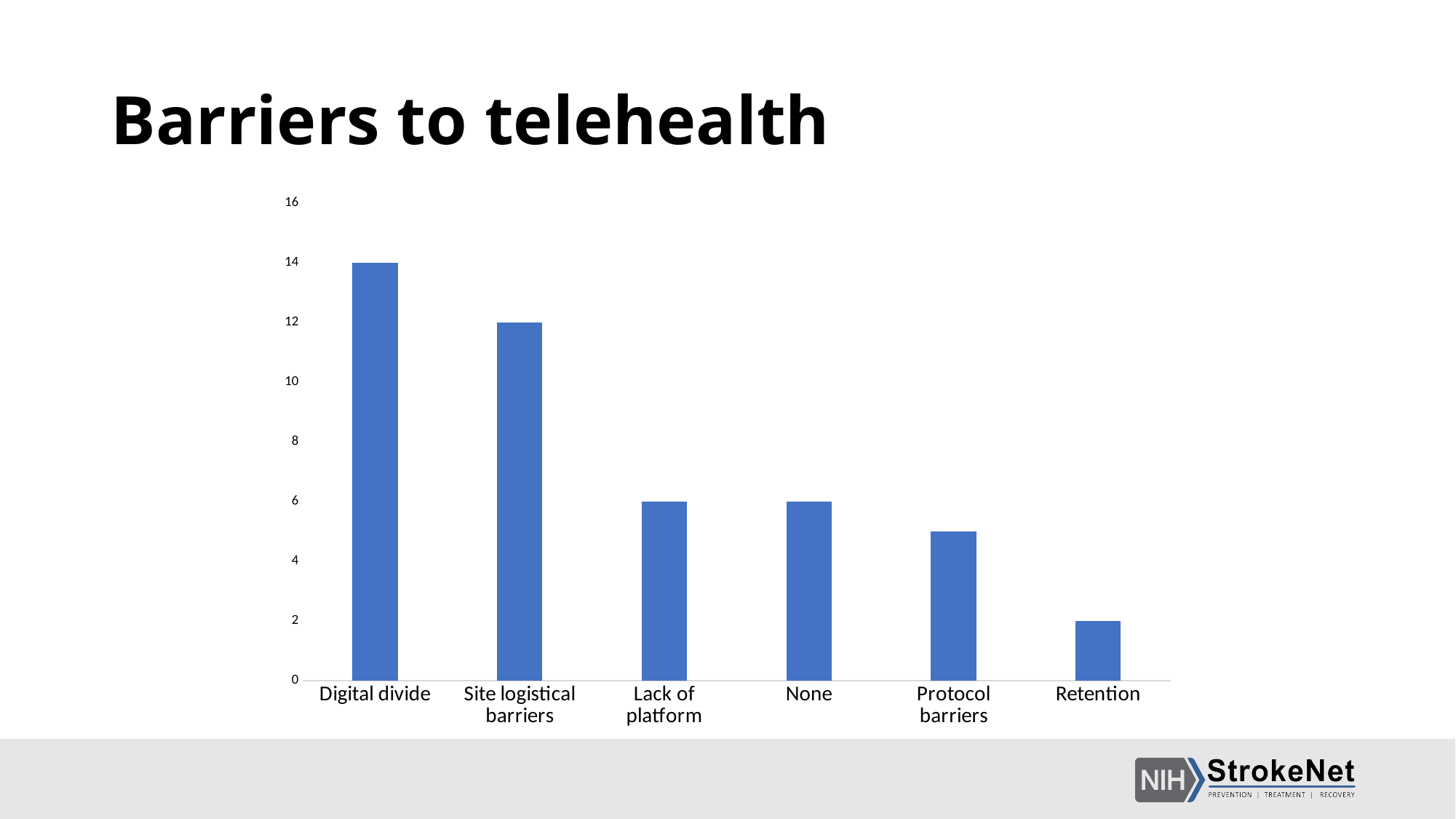
How many categories are shown on the x axis? 6 What is the title of the slide? Barriers to telehealth Which is larger, the value for Site logistical barriers or the value for None? Site logistical barriers What is the difference between the values for Digital divide and Site logistical barriers? 2 Is the value for Protocol barriers greater or less than 6? less What is the value for Lack of platform? 6 Which category has the highest value? Digital divide What kind of chart is shown on the slide? bar chart Which category has the lowest value? Retention What is the value for Digital divide? 14 What is the value for Retention? 2 What is the value for Site logistical barriers? 12